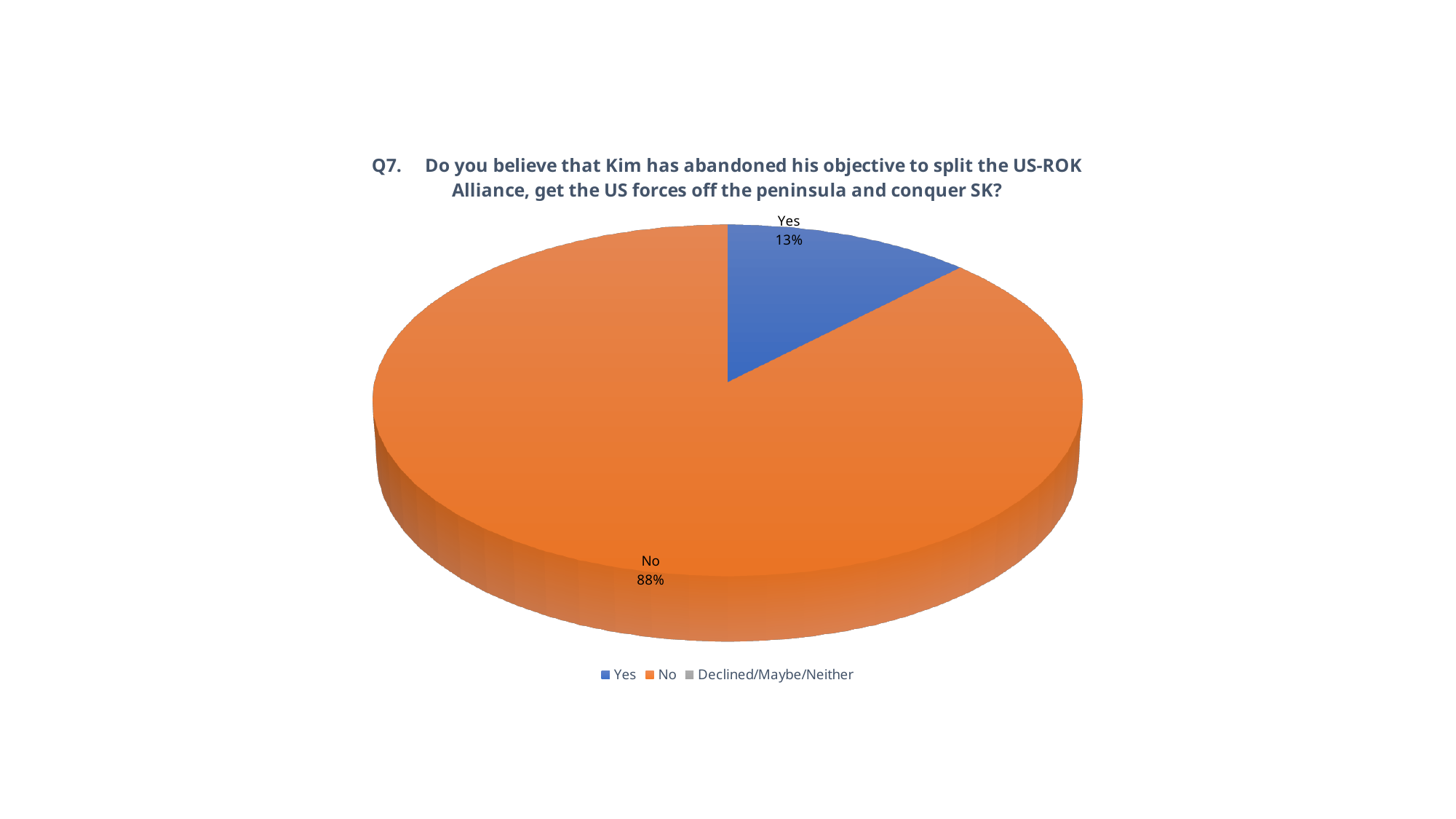
What is the difference in percentage points between the "No" and "Yes" shares? 75 Which response has the largest share of the pie? No Which of the two labelled slices, Yes or No, is smaller? Yes What percentage of respondents answered "No"? 88% What is the third legend entry after "Yes" and "No"? Declined/Maybe/Neither What percentage of respondents answered "Yes"? 13% Is the share for "No" larger or smaller than the share for "Yes"? larger What colour is the "No" slice? orange What kind of chart is shown on the slide? pie chart How many entries does the legend list? 3 How many slices are visibly labelled with a percentage on the pie? 2